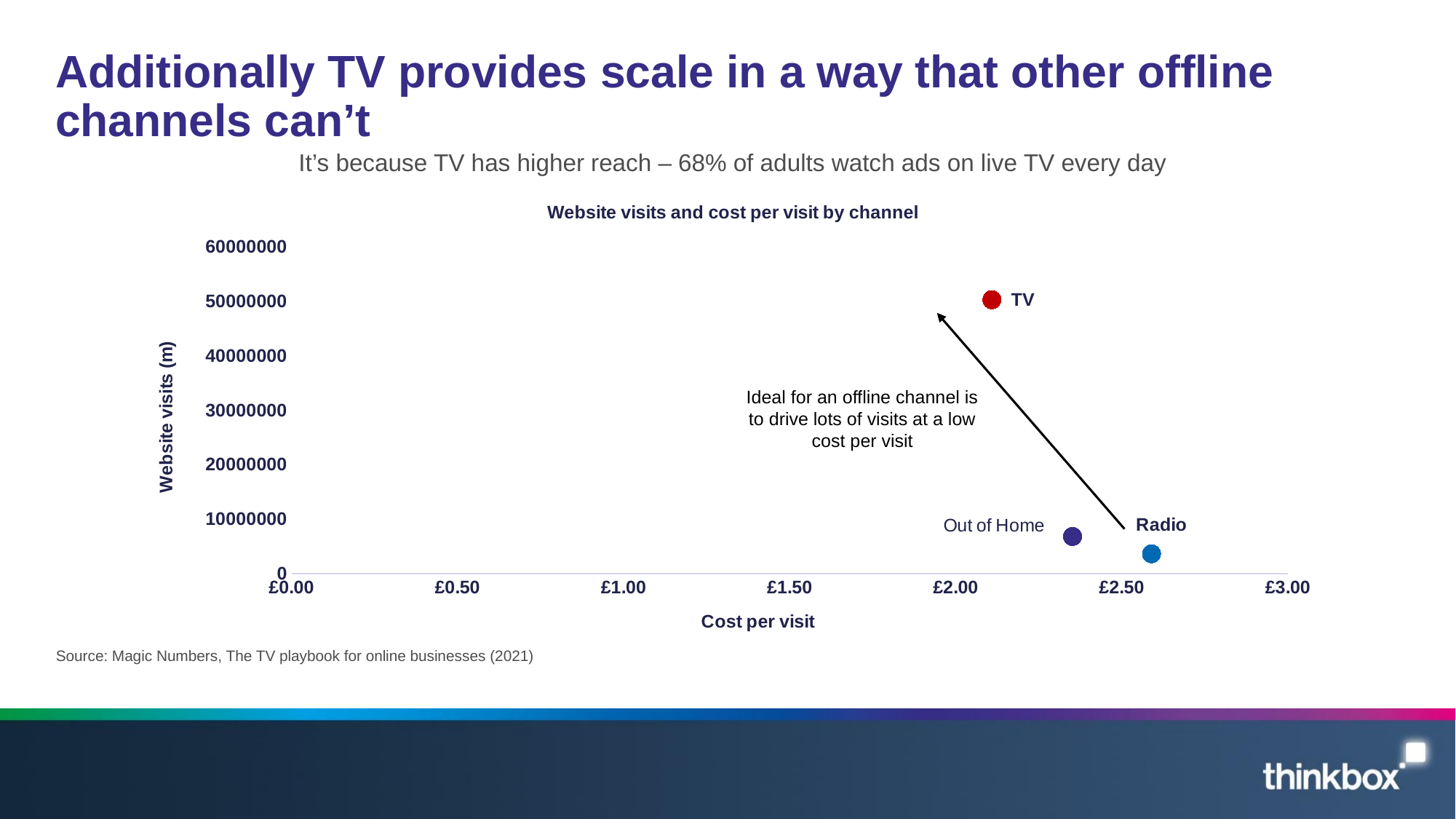
What kind of chart is shown on the slide? Scatter chart How many channels are plotted on the chart? 3 Which channel has the lowest number of website visits? Radio Which channel has the highest cost per visit? Radio Which channel has the lowest cost per visit? TV Is the cost per visit for Out of Home greater or less than £2.00? greater What is the title of the chart? Website visits and cost per visit by channel Is the cost per visit for TV greater or less than £2.50? less Is the number of website visits for Radio greater or less than 10000000? less Which channel has the highest number of website visits? TV Which channel has more website visits, TV or Out of Home? TV